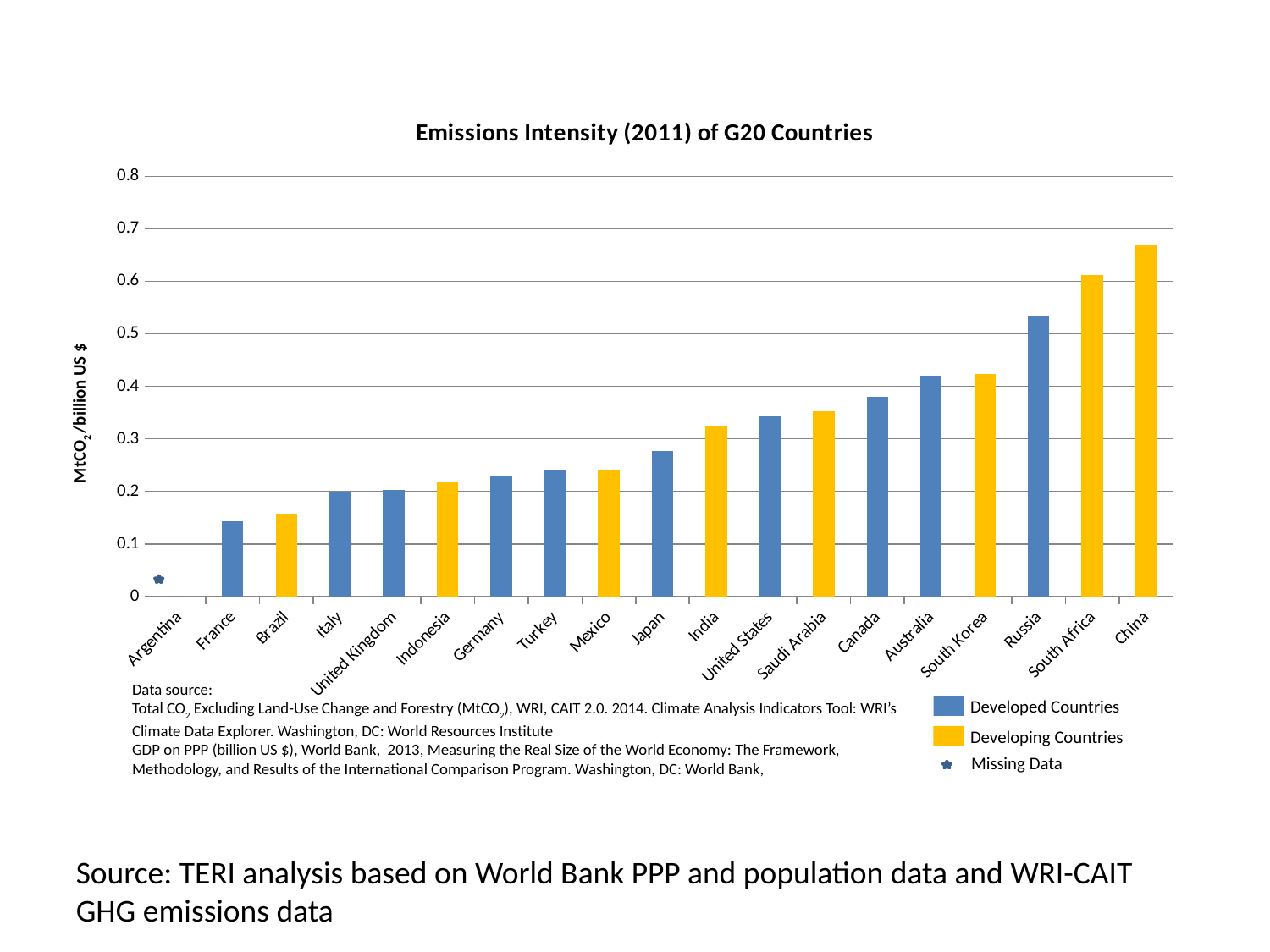
What kind of chart is shown on the slide? Bar chart Which has the higher emissions intensity, China or South Africa? China Is the value for China greater or less than 0.6? greater Which country has the highest emissions intensity in the chart? China Which has the higher emissions intensity, Russia or South Korea? Russia Do the bar values generally rise or fall from left to right along the x axis? Rise Among the countries with a plotted bar, which has the lowest emissions intensity? France Is the value for United States greater or less than 0.3? greater Is the value for Russia greater or less than 0.5? greater How many countries are listed on the x axis? 19 Which country is marked as having missing data? Argentina